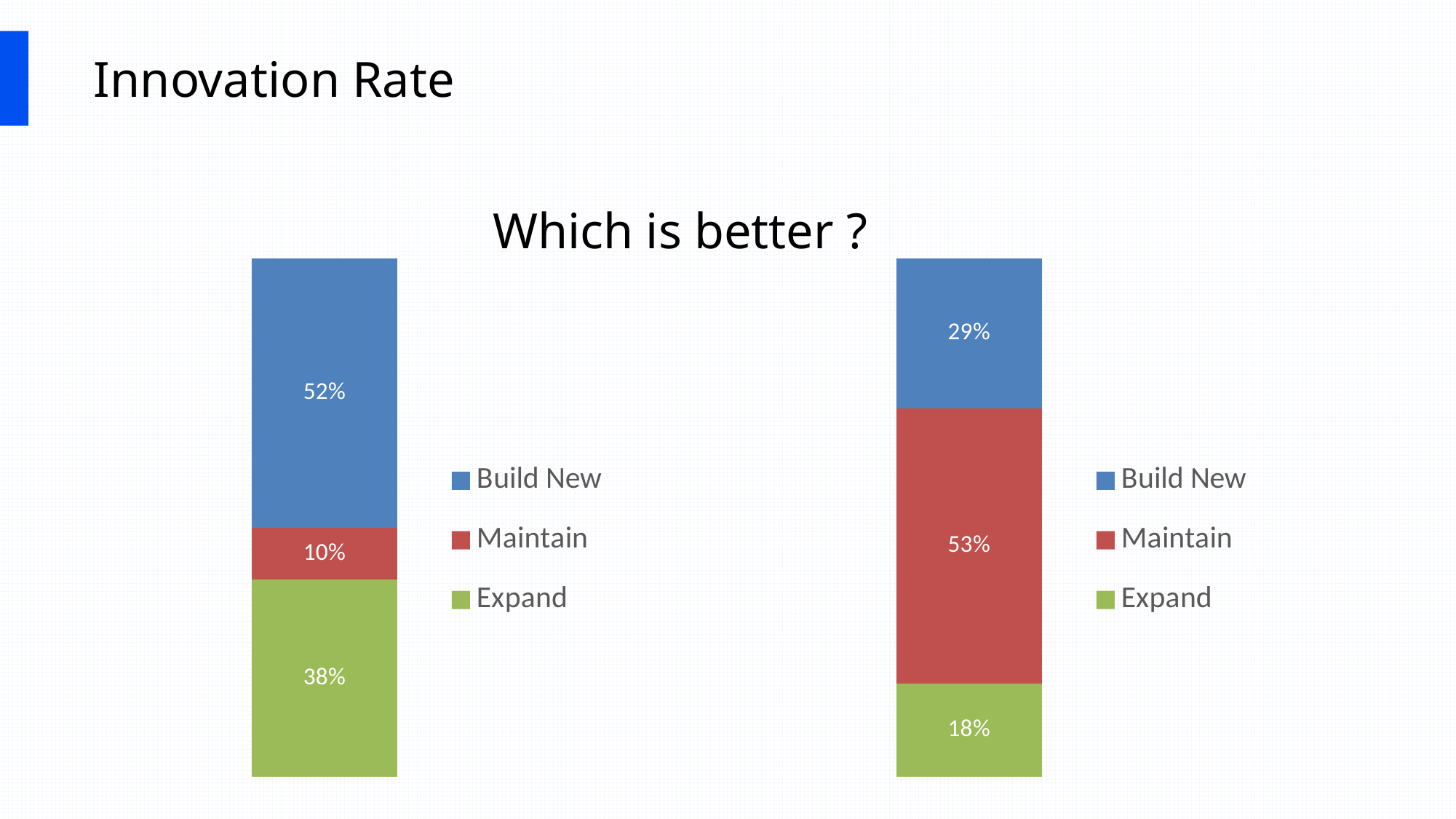
In the left chart, what is the difference between the Build New and Expand values? 14% In the left chart, what is the value for Build New? 52% In the right chart, what is the value for Expand? 18% In the right chart, what is the difference between the Maintain and Build New values? 24% What kind of chart is the right chart? stacked bar chart In the right chart, which segment has the smallest value? Expand How many series does the legend of the left chart list? 3 In the left chart, what is the value for Maintain? 10% In the right chart, what is the value for Maintain? 53% In the left chart, which segment has the largest value? Build New In the right chart, what colour is the Maintain segment? red Which chart has the larger value for Maintain, the left chart or the right chart? the right chart